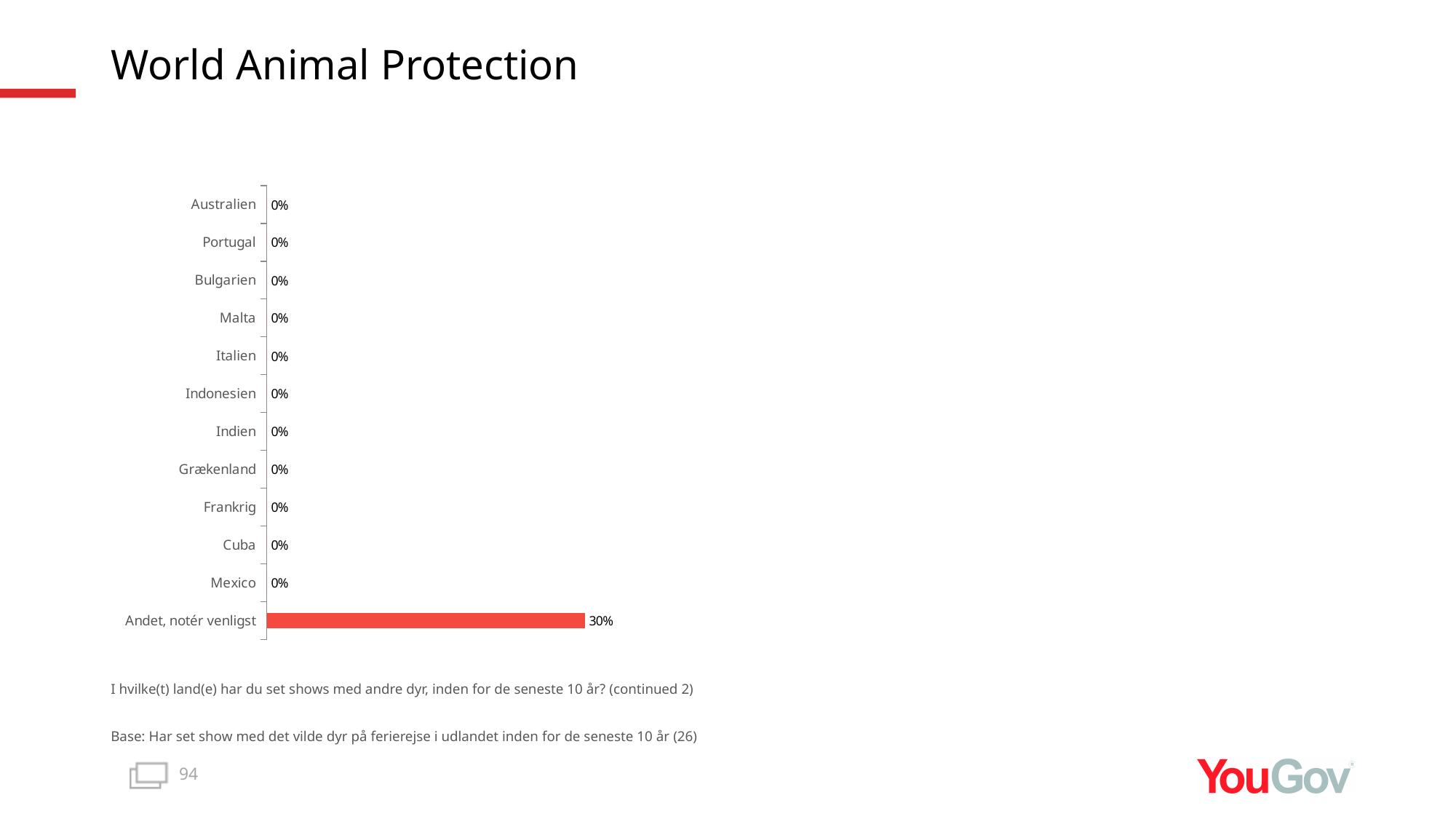
Which is larger, the value for Andet, notér venligst or the value for Frankrig? Andet, notér venligst What is the value for Andet, notér venligst? 30% What is the value for Mexico? 0% What is the difference between the values for Andet, notér venligst and Cuba? 30% What is the value for Australien? 0% How many categories have a value of 0%? 11 Which category has the highest value? Andet, notér venligst What colour is the bar for Andet, notér venligst? Red What is the value for Grækenland? 0% What is the value for Indonesien? 0% What kind of chart is shown on the slide? Bar chart How many categories are shown on the chart? 12